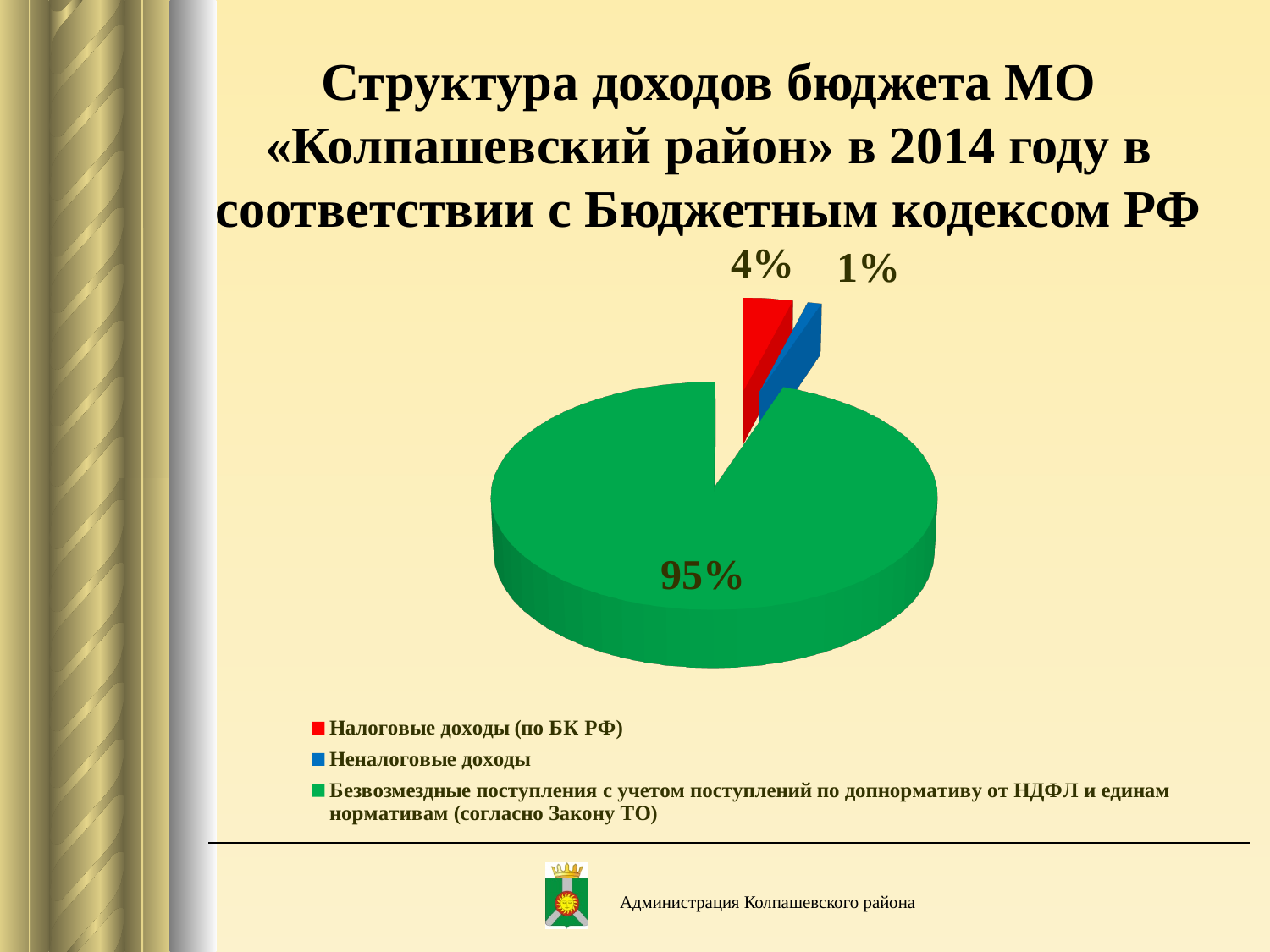
What colour is the slice for Налоговые доходы (по БК РФ)? Red What colour is the slice for Неналоговые доходы? Blue Which is larger: the slice for Налоговые доходы (по БК РФ) or the slice for Неналоговые доходы? Налоговые доходы (по БК РФ) How many entries does the legend list? 3 Which category has the largest slice of the pie? Безвозмездные поступления с учетом поступлений по допнормативу от НДФЛ и единам нормативам (согласно Закону ТО) What kind of chart is shown on the slide? Pie chart How many slices does the pie chart have? 3 What share of the pie is labelled for Безвозмездные поступления с учетом поступлений по допнормативу от НДФЛ и единам нормативам (согласно Закону ТО)? 95% What is the difference in percentage points between the Налоговые доходы (по БК РФ) slice and the Неналоговые доходы slice? 3 percentage points What share of the pie is labelled for Неналоговые доходы? 1% What share of the pie is labelled for Налоговые доходы (по БК РФ)? 4% Which category has the smallest slice of the pie? Неналоговые доходы